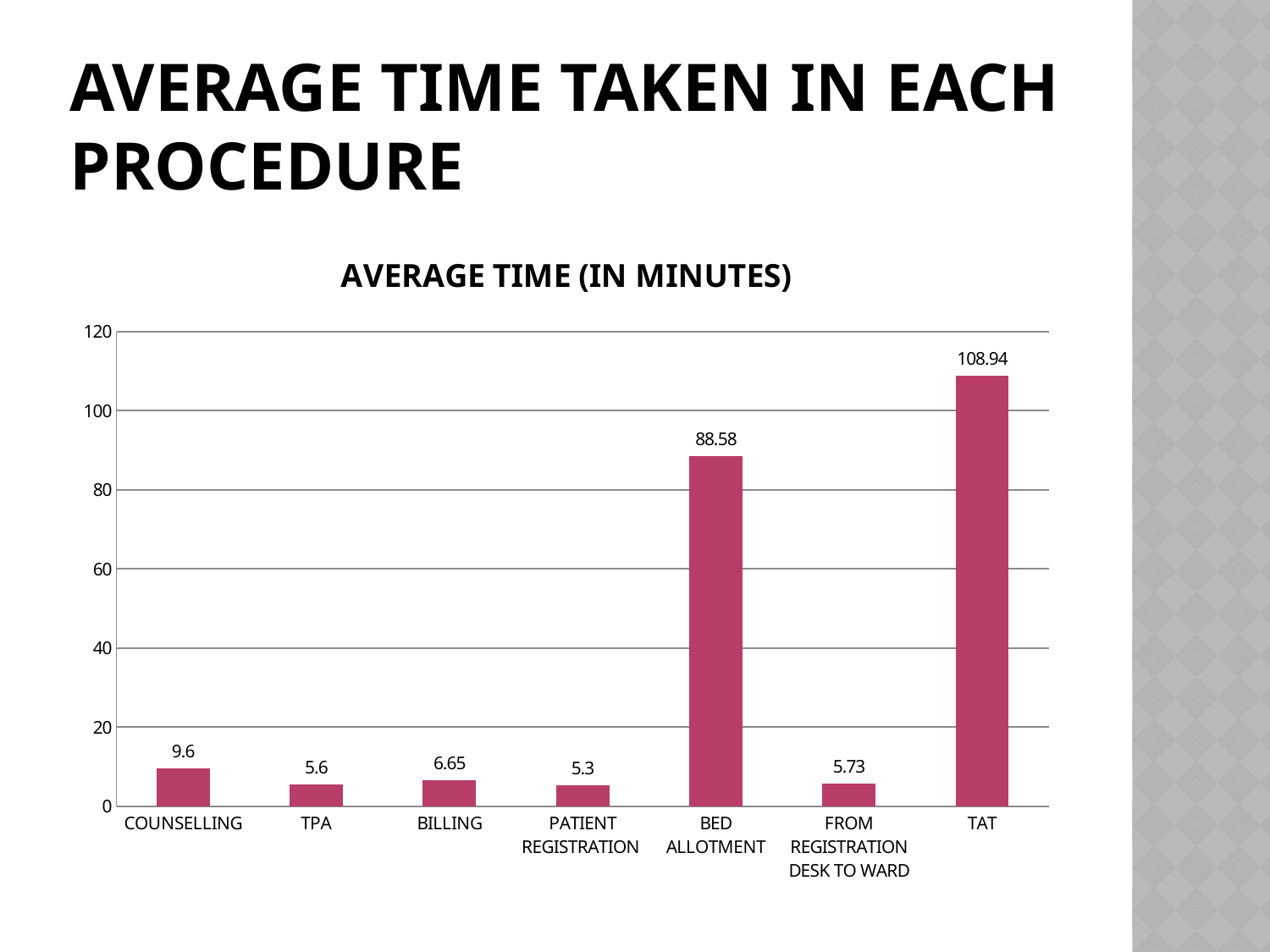
Which has a larger average time, BILLING or TPA? BILLING What kind of chart is shown on the slide? bar chart Which procedure has the lowest average time? PATIENT REGISTRATION Is the value for BED ALLOTMENT greater or less than 100? less What is the average time in minutes for FROM REGISTRATION DESK TO WARD? 5.73 Which procedure has the highest average time? TAT What is the title of the chart? AVERAGE TIME (IN MINUTES) What is the difference between the average time for TAT and BED ALLOTMENT? 20.36 What is the difference between the average time for COUNSELLING and TPA? 4 What is the average time in minutes for BED ALLOTMENT? 88.58 How many procedures are shown on the x axis? 7 What is the average time in minutes for COUNSELLING? 9.6